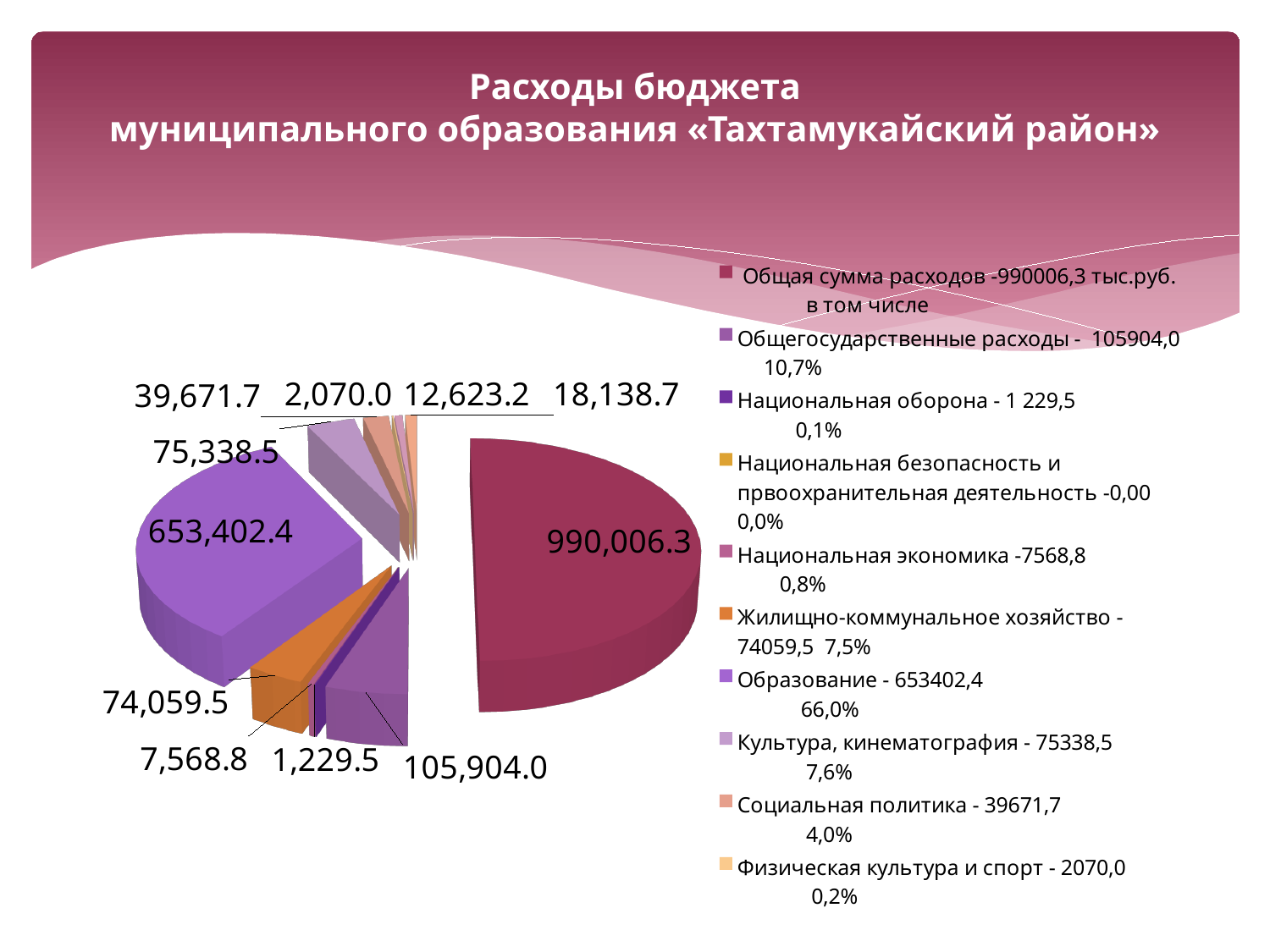
Excluding the total expenditure slice, which category has the largest value? Образование What is the title of the slide's chart? Расходы бюджета муниципального образования «Тахтамукайский район» What value is shown for Культура, кинематография? 75,338.5 What kind of chart is shown on the slide? pie chart What value is shown for Общегосударственные расходы? 105,904.0 What value is shown for Жилищно-коммунальное хозяйство? 74,059.5 What value is shown for Образование? 653,402.4 What value is shown for Национальная оборона? 1,229.5 Which is larger: Культура, кинематография or Жилищно-коммунальное хозяйство? Культура, кинематография According to the legend, what share of total expenditure does Образование account for? 66,0% What value is shown for Социальная политика? 39,671.7 What is the difference between the values for Культура, кинематография and Жилищно-коммунальное хозяйство? 1,279.0